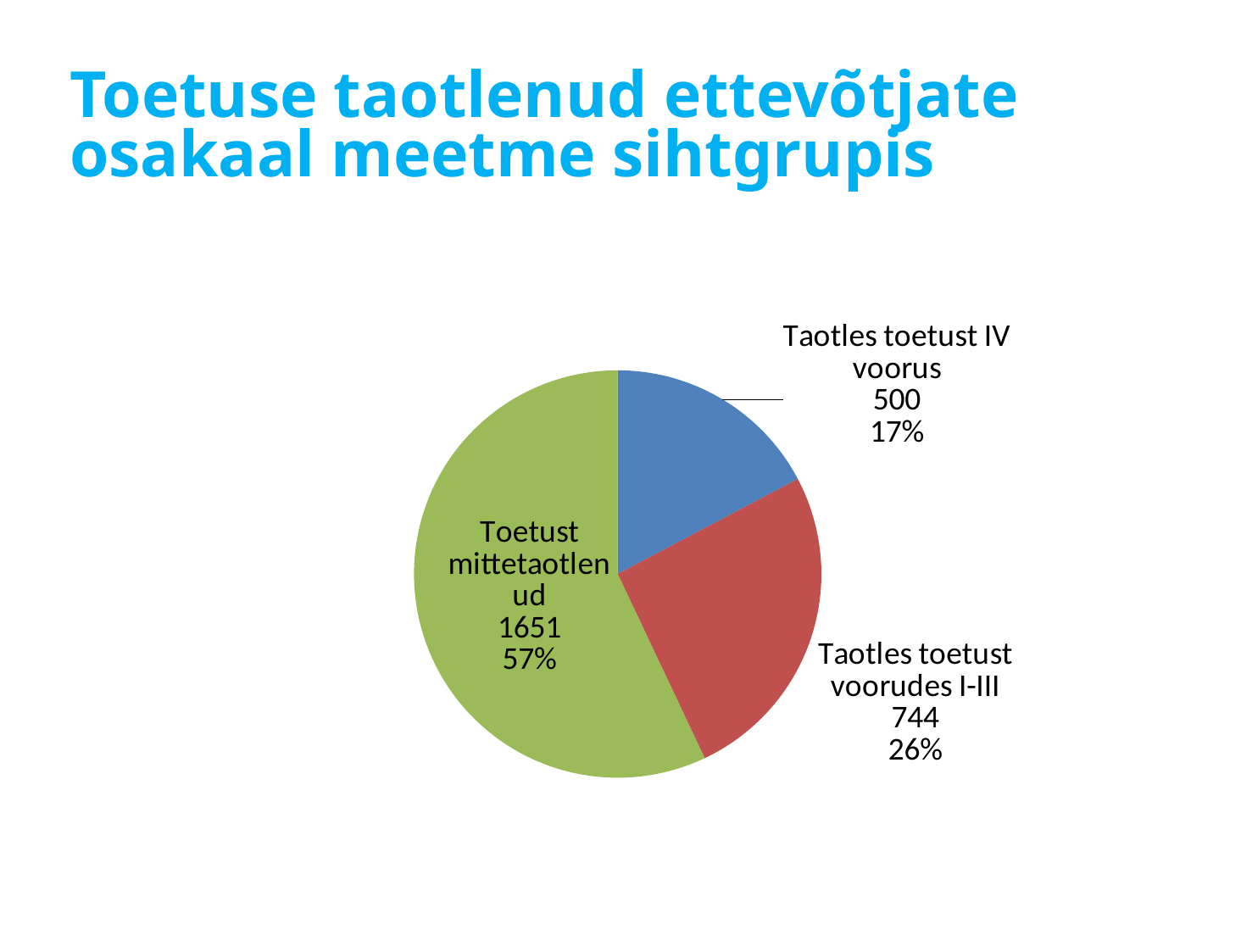
What is the value for "Taotles toetust voorudes I-III"? 744 What share of the pie does "Taotles toetust voorudes I-III" represent? 26% What share of the pie does "Taotles toetust IV voorus" represent? 17% Which slice is the smallest? Taotles toetust IV voorus What is the value for "Toetust mittetaotlenud"? 1651 Which slice is the largest? Toetust mittetaotlenud What share of the pie does "Toetust mittetaotlenud" represent? 57% Which is larger: "Taotles toetust voorudes I-III" or "Taotles toetust IV voorus"? Taotles toetust voorudes I-III What kind of chart is shown on the slide? pie chart How many slices does the pie chart have? 3 What is the value for "Taotles toetust IV voorus"? 500 What is the difference between the values for "Taotles toetust voorudes I-III" and "Taotles toetust IV voorus"? 244